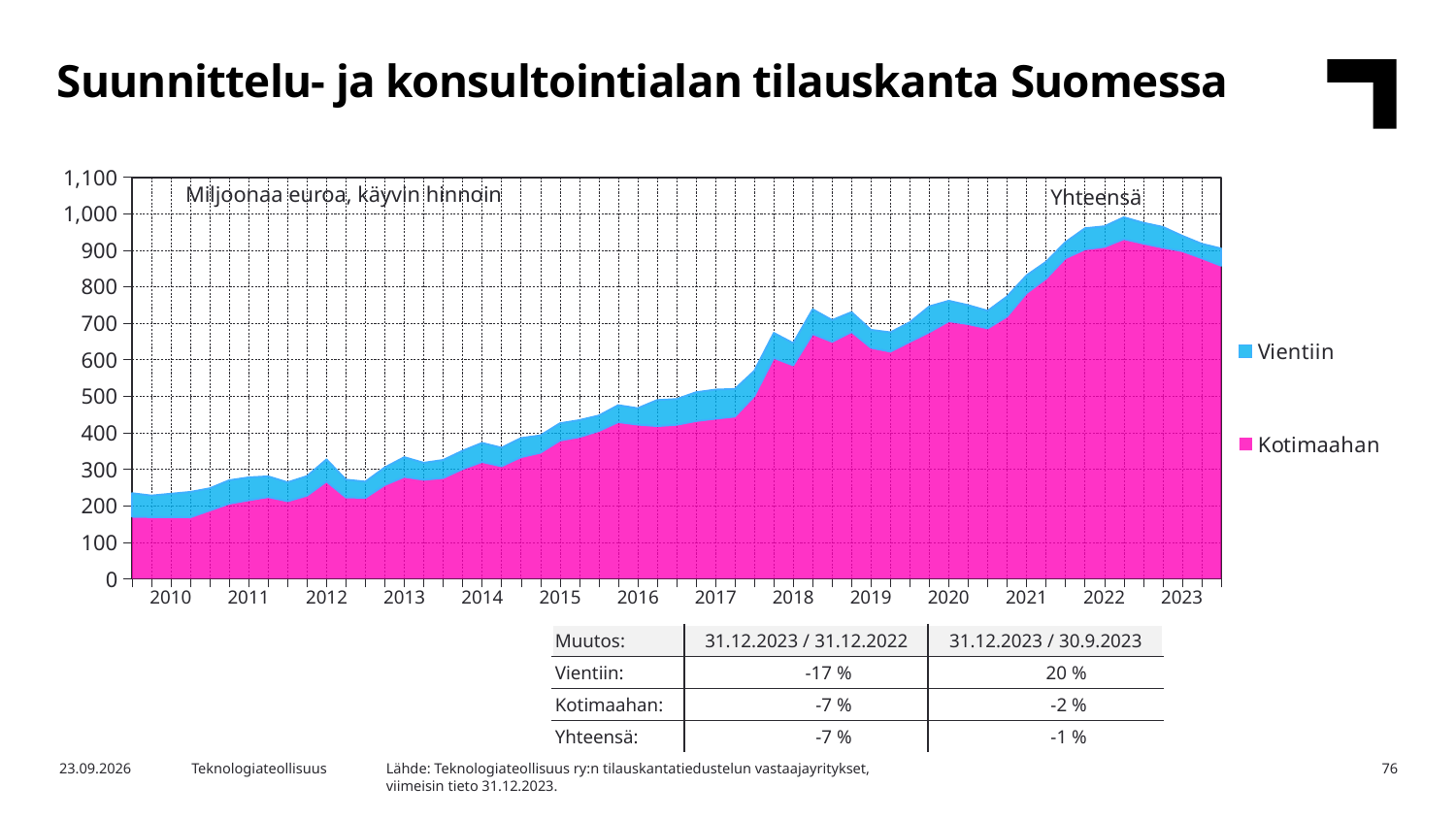
Which series, Vientiin or Kotimaahan, has the larger values throughout the chart? Kotimaahan In which year does the total (Yhteensä) reach its highest level? 2022 What kind of chart is shown on the slide? Stacked area chart Is the total value at the 2022 peak greater or less than 900? greater In which year is the total (Yhteensä) at its lowest level? 2010 How many years are labelled on the x axis of the chart? 14 Which two series are listed in the chart legend? Vientiin and Kotimaahan Does the total order backlog generally rise or fall from 2010 to 2022? rise Is the Kotimaahan value at the start of 2010 greater or less than 200? less What unit is stated in the label inside the chart area? Miljoonaa euroa, käyvin hinnoin How many series does the chart legend list? 2 According to the table below the chart, what is the change for Vientiin between 31.12.2022 and 31.12.2023? -17 %